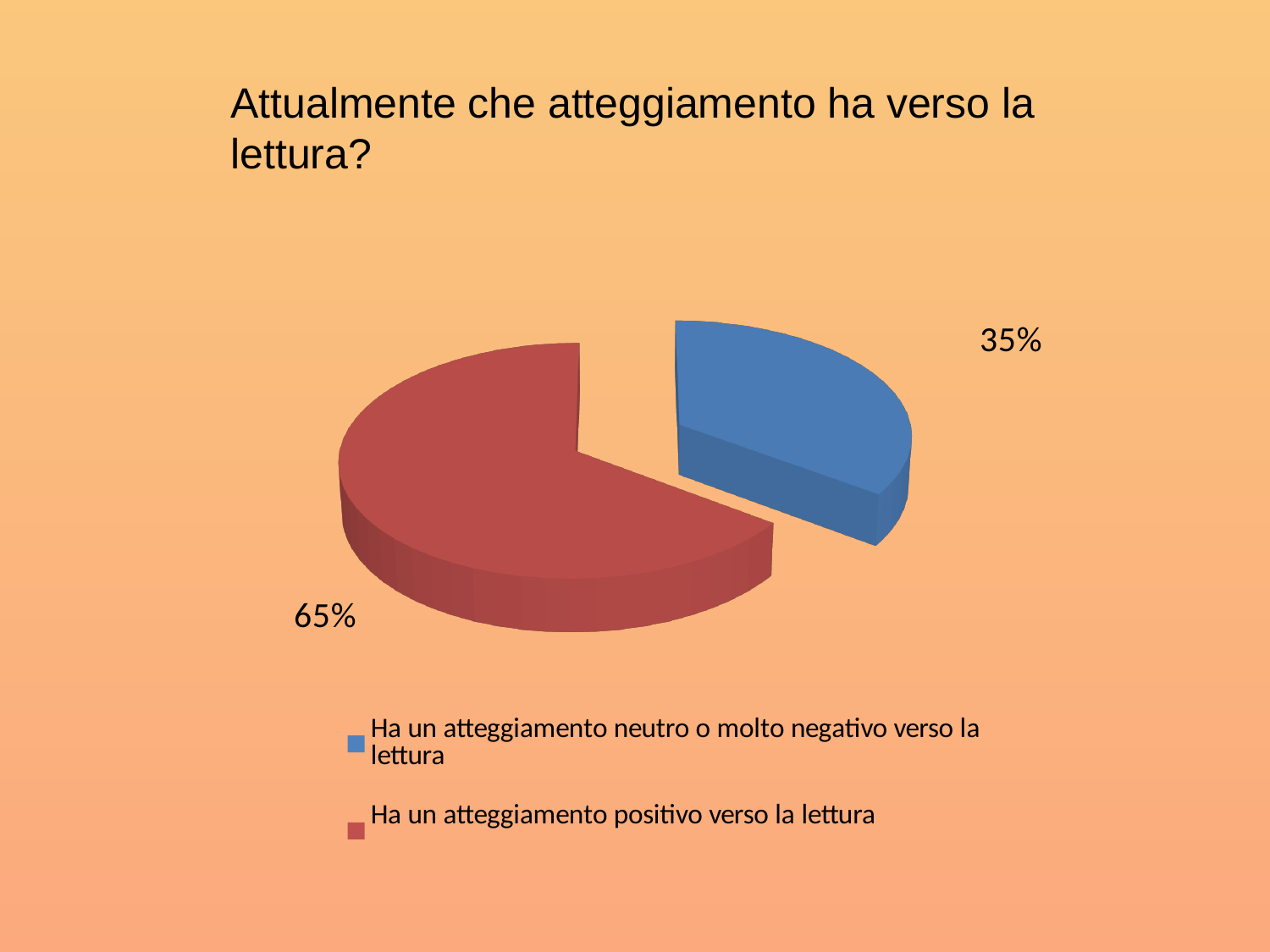
What colour is the slice for 'Ha un atteggiamento positivo verso la lettura'? Red What share of the pie is labelled for 'Ha un atteggiamento neutro o molto negativo verso la lettura'? 35% Which category has the smallest slice of the pie? Ha un atteggiamento neutro o molto negativo verso la lettura Which is larger: the slice for a positive attitude toward reading or the slice for a neutral or very negative attitude? Ha un atteggiamento positivo verso la lettura What share of the pie is labelled for 'Ha un atteggiamento positivo verso la lettura'? 65% What is the title of the slide above the chart? Attualmente che atteggiamento ha verso la lettura? What kind of chart is shown on the slide? Pie chart Which category has the largest slice of the pie? Ha un atteggiamento positivo verso la lettura How many slices does the pie chart have? 2 What is the difference in percentage points between the positive-attitude slice and the neutral-or-negative slice? 30 How many entries does the legend list? 2